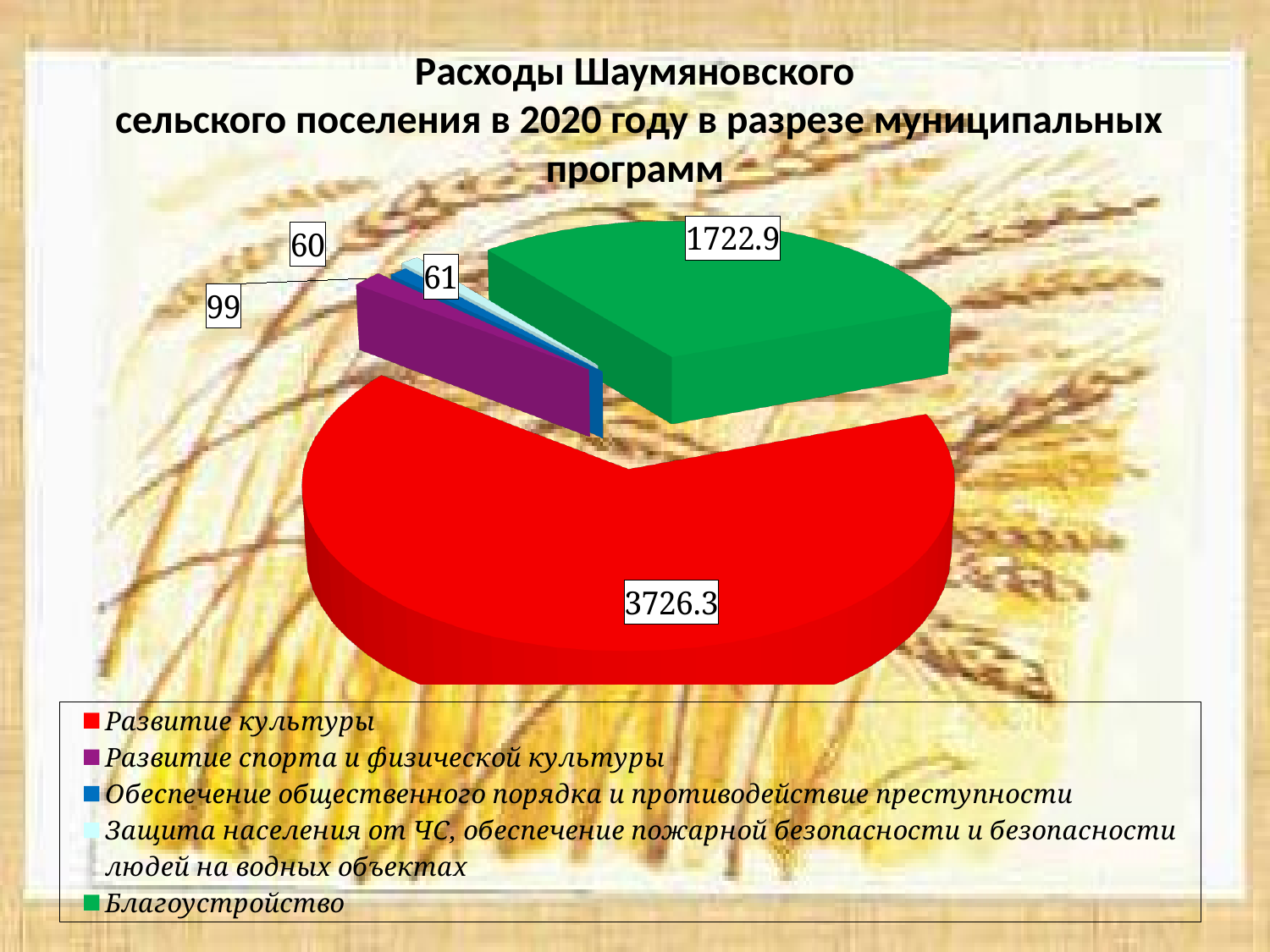
Which is larger, the value for Развитие культуры or the value for Благоустройство? Развитие культуры What is the difference between the values for Развитие культуры and Благоустройство? 2003.4 How many categories does the pie chart have? 5 What is the value for Благоустройство? 1722.9 How many entries does the legend list? 5 Which category has the largest slice of the pie? Развитие культуры What colour is the slice for Благоустройство? green Which is larger, the value for Благоустройство or the value for Развитие спорта и физической культуры? Благоустройство Which category is shown in red in the legend? Развитие культуры What kind of chart is shown on the slide? pie chart What is the value for Развитие спорта и физической культуры? 99 What is the value for Развитие культуры? 3726.3